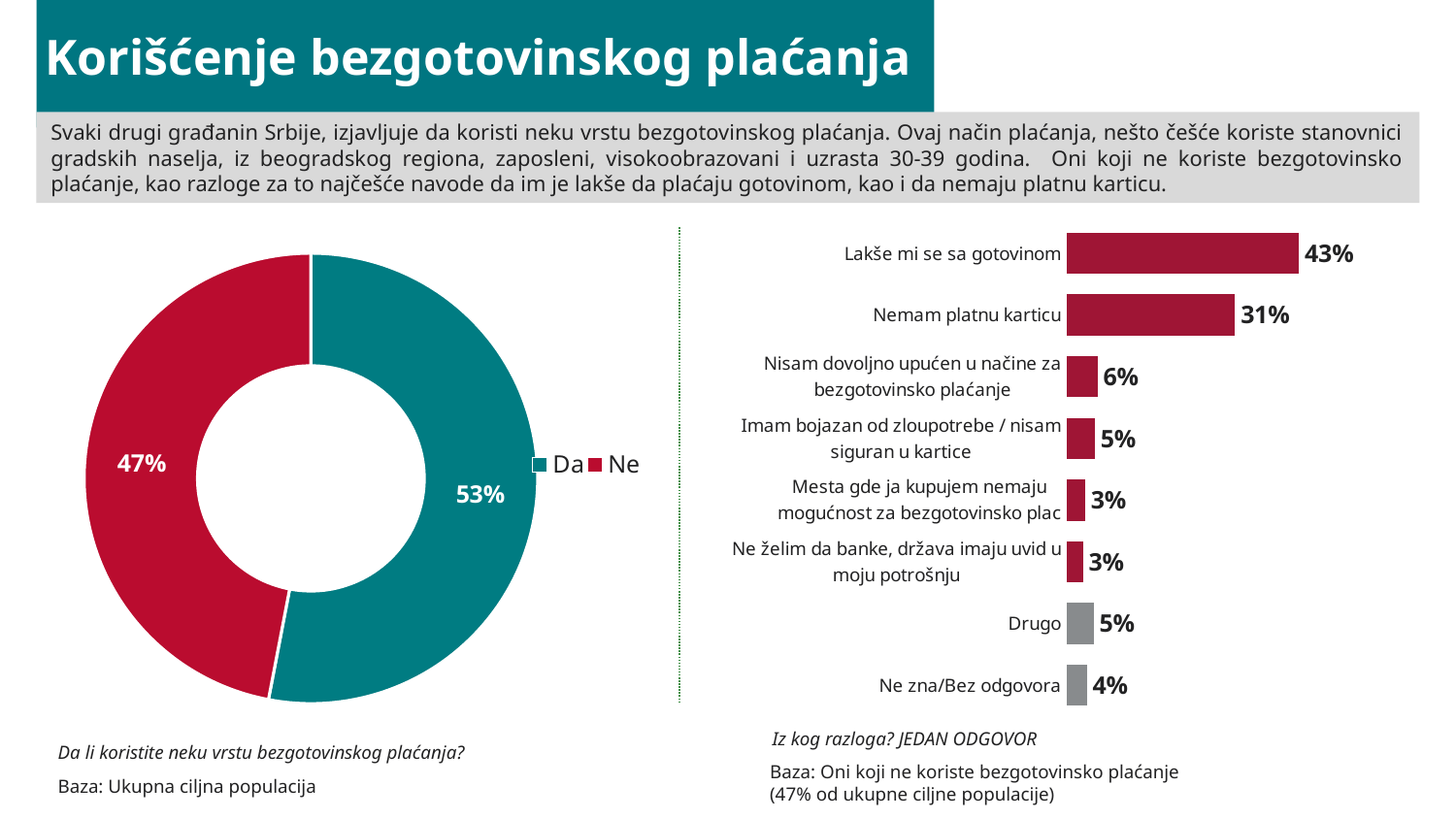
In the bar chart on the right, what is the value for "Ne zna/Bez odgovora"? 4% What kind of chart is shown on the right side of the slide? Bar chart What kind of chart is shown on the left side of the slide? Donut (pie) chart In the donut chart on the left, how many entries does the legend list? 2 In the bar chart on the right, which category has the highest value? Lakše mi se sa gotovinom In the bar chart on the right, what is the difference between "Lakše mi se sa gotovinom" and "Nemam platnu karticu"? 12% In the bar chart on the right, how many categories are shown? 8 In the bar chart on the right, what is the value for "Lakše mi se sa gotovinom"? 43% In the donut chart on the left, what share of respondents answered "Da"? 53% In the bar chart on the right, what is the value for "Nemam platnu karticu"? 31% In the donut chart on the left, what share of respondents answered "Ne"? 47% In the donut chart on the left, which answer has the larger share, "Da" or "Ne"? Da